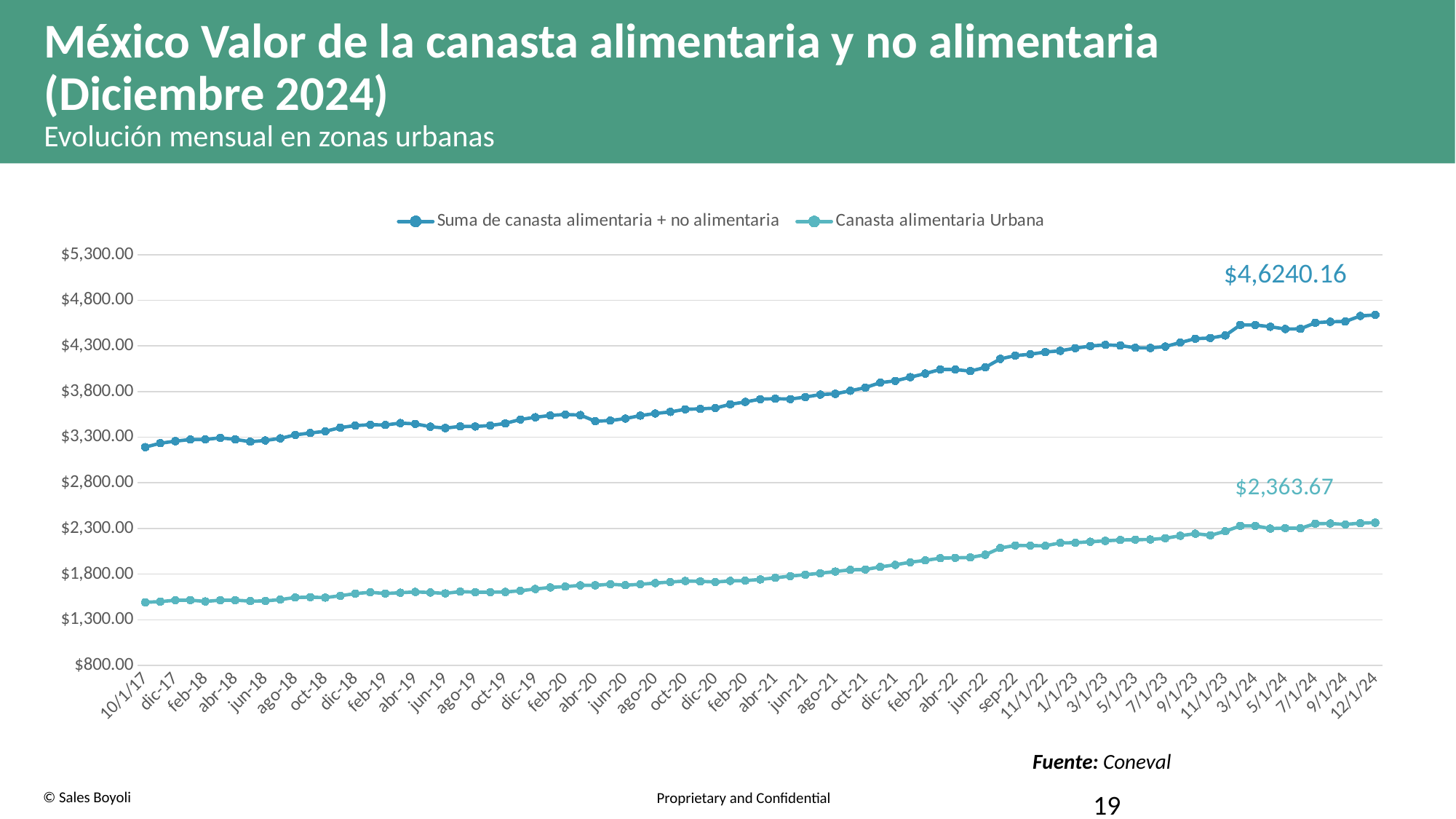
Is the value of 'Canasta alimentaria Urbana' at 12/1/24 greater or less than $2,800.00? less Is the value of 'Suma de canasta alimentaria + no alimentaria' at jun-22 greater or less than $4,300.00? less What is the value of the 'Canasta alimentaria Urbana' series at 12/1/24, as labelled on the chart? $2,363.67 Is the value of 'Canasta alimentaria Urbana' at 10/1/17 greater or less than $1,800.00? less What kind of chart is shown on the slide? Line chart Which series has the higher value at 12/1/24? Suma de canasta alimentaria + no alimentaria Which series reaches the highest value on the chart? Suma de canasta alimentaria + no alimentaria How many series does the legend list? 2 What source is cited for the chart data? Coneval Do the values of 'Suma de canasta alimentaria + no alimentaria' generally rise or fall from 10/1/17 to 12/1/24? Rise What is the value of the 'Suma de canasta alimentaria + no alimentaria' series at 12/1/24, as labelled on the chart? $4,6240.16